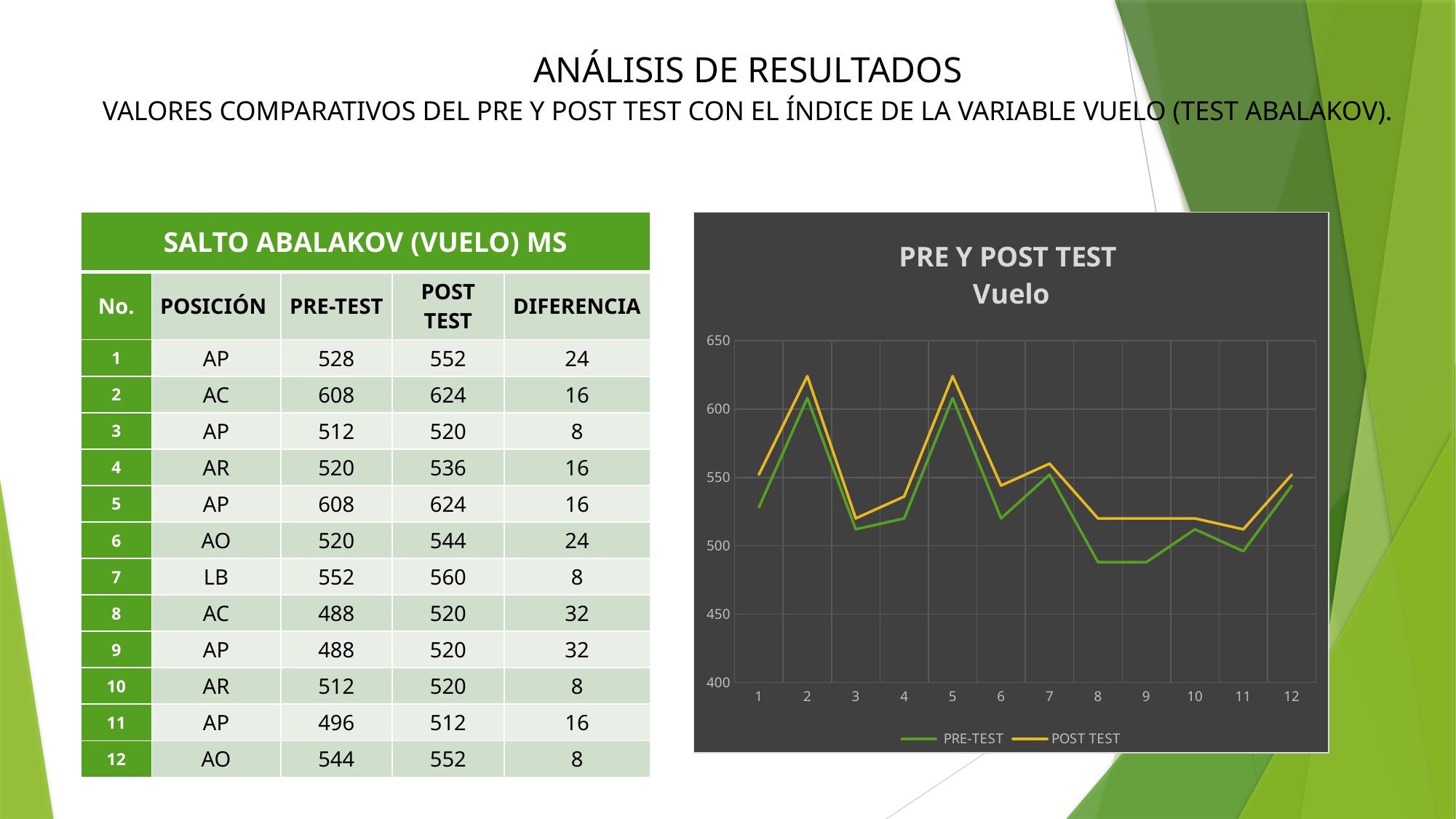
Is the PRE-TEST value at point 8 greater or less than 500? less Which is larger at point 7, the PRE-TEST value or the POST TEST value? POST TEST What is the PRE-TEST value for point 2? 608 How many points are plotted along the x axis of the chart? 12 How many series does the legend of the chart list? 2 What is the POST TEST value for point 8? 520 Is the POST TEST value at point 5 greater or less than 600? greater What is the title of the chart? PRE Y POST TEST Vuelo What type of chart is shown on the slide? line chart Which point has the lowest PRE-TEST value? 8 and 9 (488) Which colour is used for the POST TEST line in the chart? yellow/orange What is the difference between the POST TEST and PRE-TEST values at point 9? 32